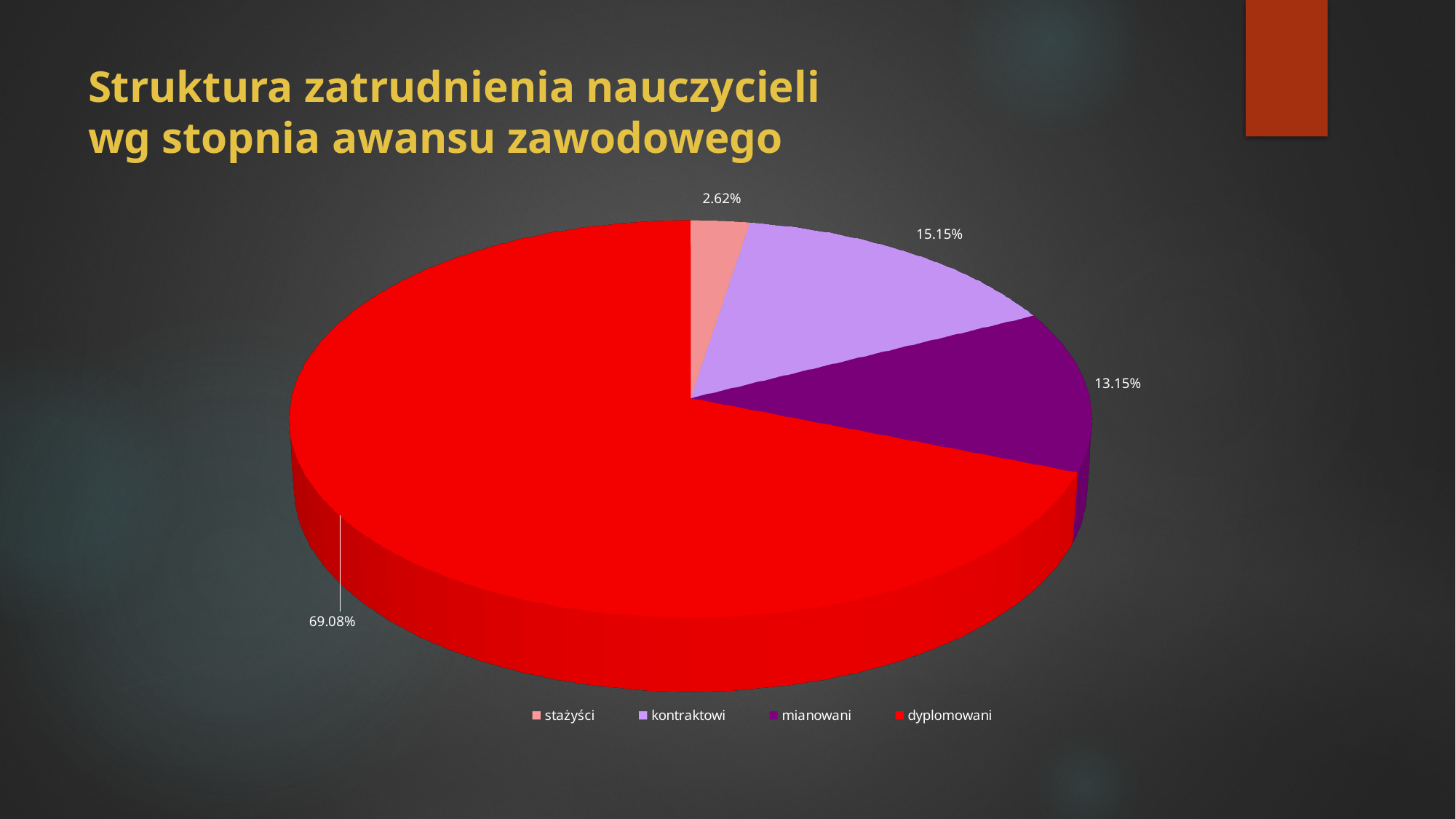
What percentage of the pie is the kontraktowi slice? 15.15% What kind of chart is shown on the slide? pie chart How many categories does the pie chart show? 4 What colour is the dyplomowani slice in the pie chart? red Which category has the smallest share of the pie? stażyści Which slice is larger, kontraktowi or mianowani? kontraktowi What percentage of the pie is the stażyści slice? 2.62% What percentage of the pie is the mianowani slice? 13.15% Which category has the largest share of the pie? dyplomowani What is the difference in percentage points between the kontraktowi and mianowani slices? 2 percentage points What percentage of the pie is the dyplomowani slice? 69.08% What is the title of the chart on the slide? Struktura zatrudnienia nauczycieli wg stopnia awansu zawodowego